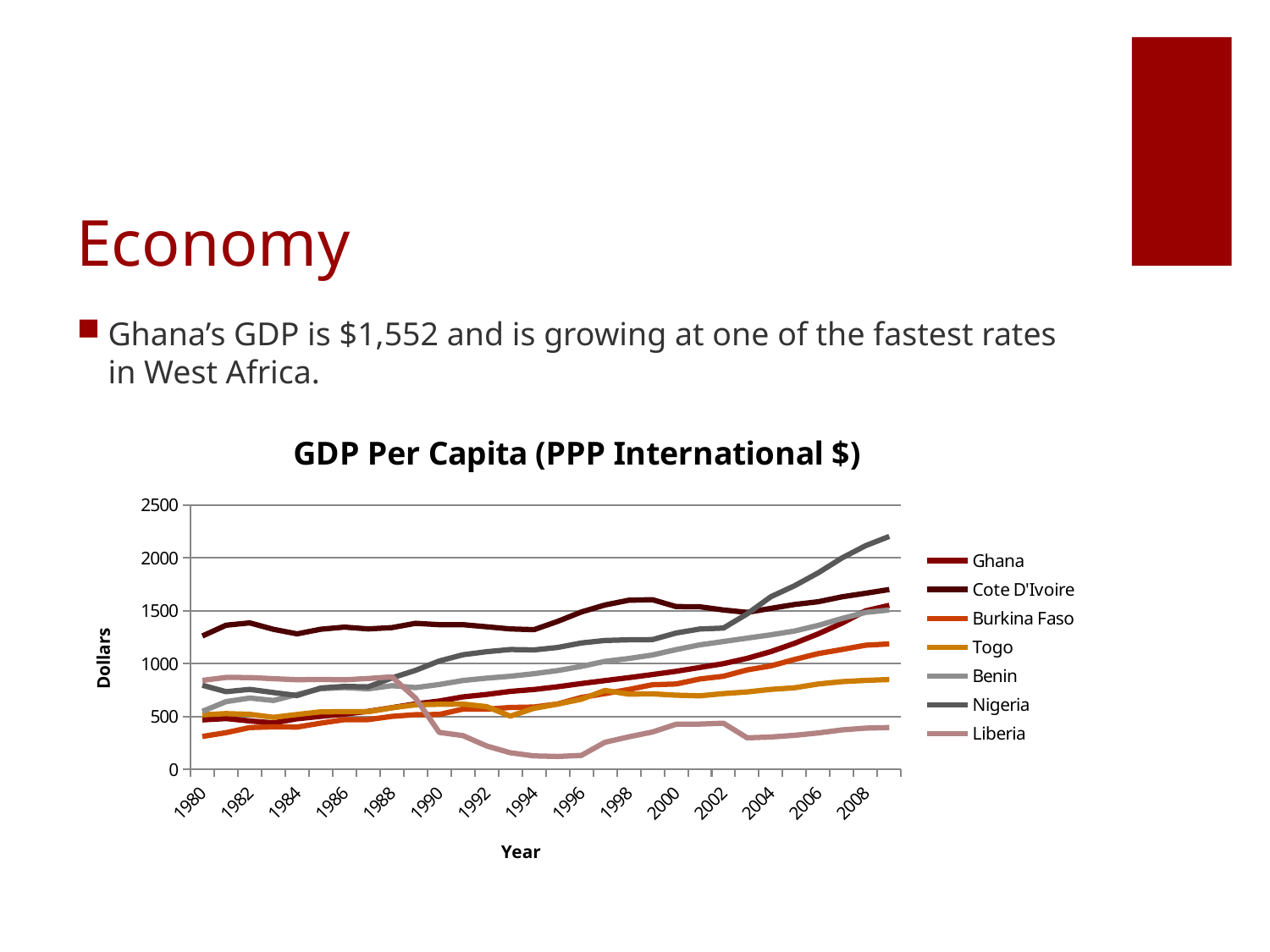
Does the Nigeria line generally rise or fall from 1980 to 2008? rise What is the label on the vertical axis of the chart? Dollars How many series does the legend of the GDP Per Capita chart list? 7 Is the value for Nigeria in 2008 greater or less than 2000? greater Which country has the lowest GDP per capita in 2008? Liberia Is the value for Liberia in 1996 greater or less than 500? less In 2008, which is larger, the value for Benin or the value for Togo? Benin Which country has the highest GDP per capita in 2008? Nigeria What kind of chart is shown on the slide? line chart Which country has the lowest GDP per capita in 1980? Burkina Faso What is the title of the chart on the slide? GDP Per Capita (PPP International $) Which country has the highest GDP per capita in 1980? Cote D'Ivoire